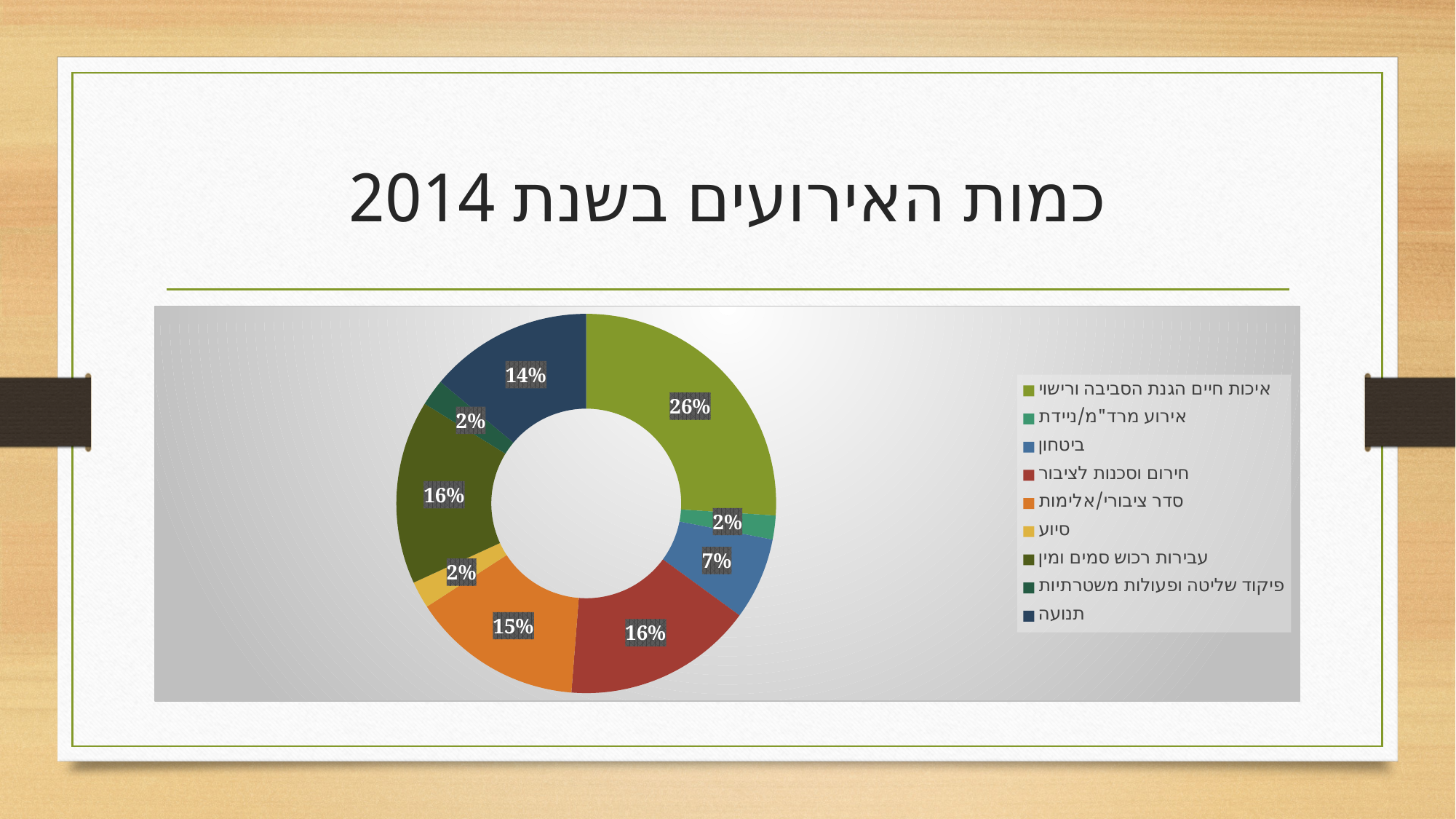
What percentage is shown for סדר ציבורי/אלימות? 15% What colour is the slice for תנועה? Dark blue What percentage is shown for ביטחון? 7% What is the title of the chart slide? כמות האירועים בשנת 2014 What percentage is shown for איכות חיים הגנת הסביבה ורישוי? 26% Which is larger, the share for חירום וסכנות לציבור or the share for ביטחון? חירום וסכנות לציבור What is the difference in percentage points between איכות חיים הגנת הסביבה ורישוי and תנועה? 12 What kind of chart is shown on the slide? Doughnut (pie) chart Which category has the largest share of the chart? איכות חיים הגנת הסביבה ורישוי What percentage is shown for תנועה? 14% How many categories are labelled 2%? 3 How many categories does the legend list? 9